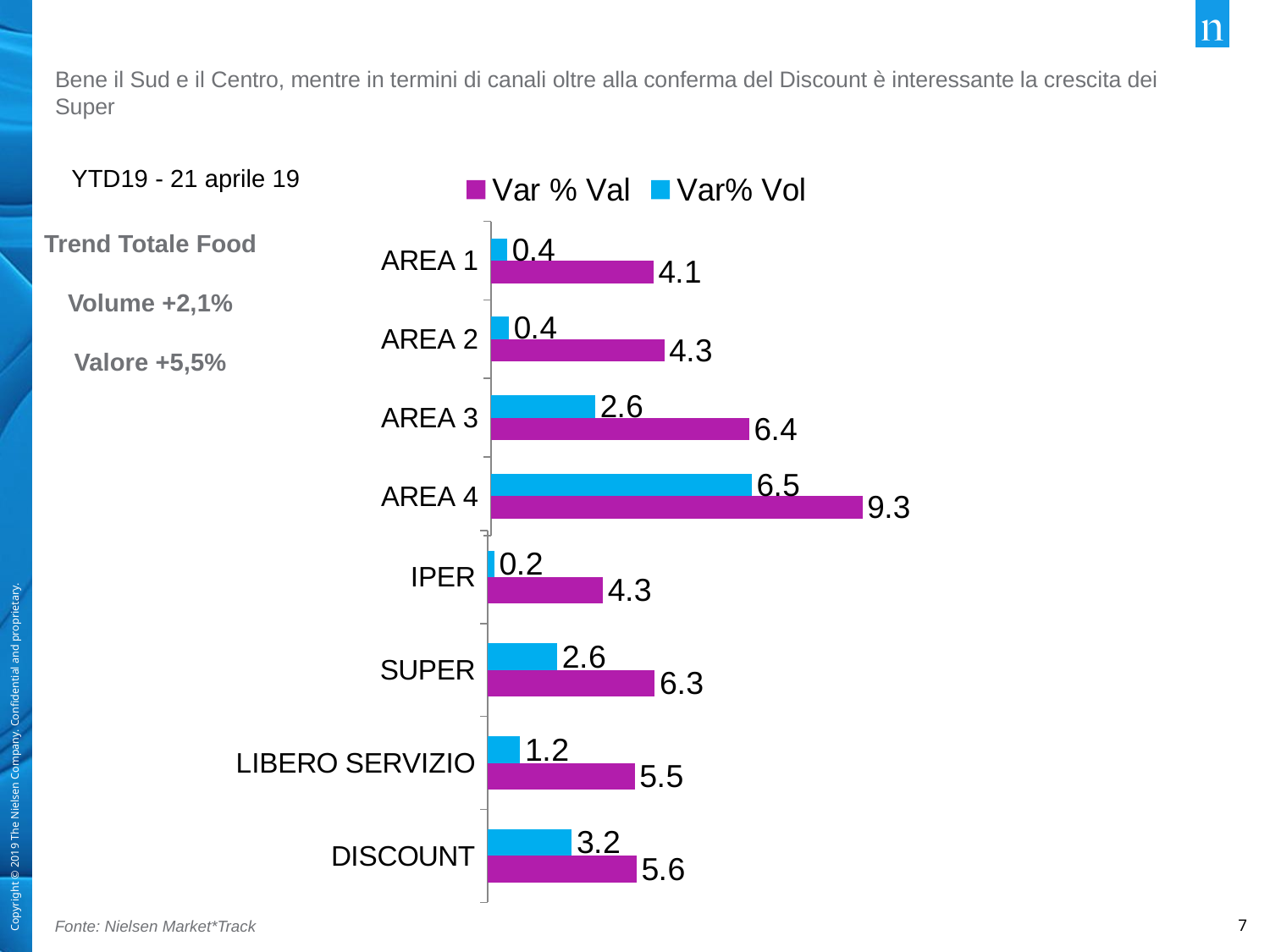
What kind of chart is shown on the slide? Bar chart What is the Var% Vol value for SUPER? 2.6 Which series is shown in purple in the legend? Var % Val How many categories are shown on the chart? 8 Which category has the lowest Var% Vol value? IPER Which is larger, the Var% Vol value for DISCOUNT or the Var% Vol value for SUPER? DISCOUNT What is the Var % Val value for LIBERO SERVIZIO? 5.5 What is the difference between the Var % Val values for AREA 4 and AREA 1? 5.2 What is the Var % Val value for AREA 4? 9.3 Which category has the highest Var % Val value? AREA 4 What is the difference between the Var % Val and Var% Vol values for AREA 3? 3.8 How many series does the legend list? 2